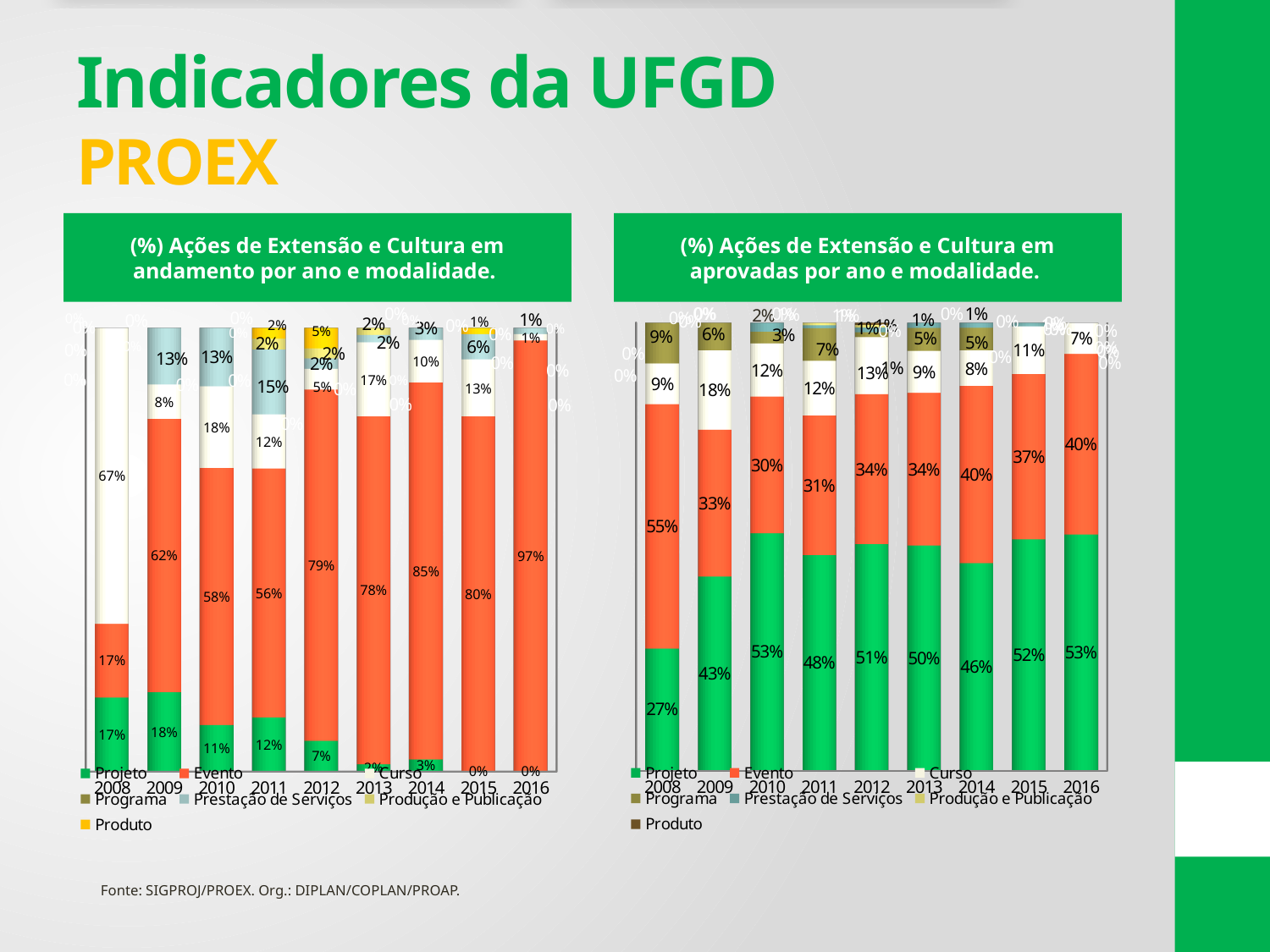
In the left chart (ações em andamento), which is larger: the Evento value for 2012 or for 2013? 2012 In the left chart (ações em andamento), which year has the highest Evento value? 2016 In the right chart (ações aprovadas), which year has the lowest Projeto value? 2008 In the left chart (ações em andamento), what is the Evento value for 2016? 97% In the right chart (ações aprovadas), what is the difference between the Projeto values for 2009 and 2008? 16% What type of chart is the right chart (ações aprovadas)? Stacked bar chart In the left chart (ações em andamento), does the Projeto value rise or fall from 2009 to 2016? Fall In the right chart (ações aprovadas), what is the Evento value for 2008? 55% How many years are shown on the x axis of the right chart (ações aprovadas)? 9 How many series does the legend of the left chart (ações em andamento) list? 7 In the right chart (ações aprovadas), what is the Projeto value for 2010? 53% In the left chart (ações em andamento), what is the Curso value for 2008? 67%